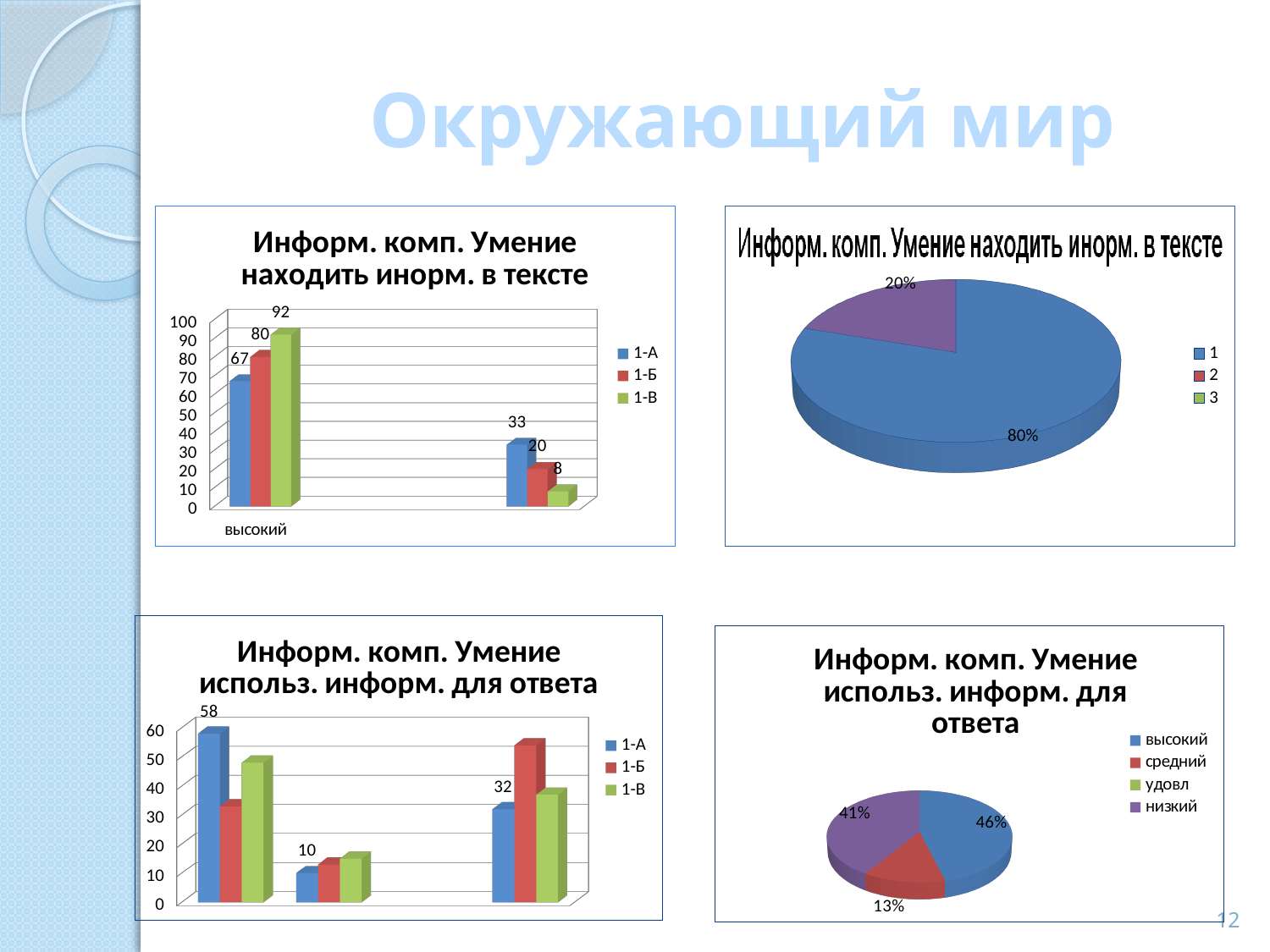
In the top-left bar chart 'Информ. комп. Умение находить инорм. в тексте', which series has the highest value in the 'высокий' category? 1-В In the bottom-left bar chart 'Информ. комп. Умение использ. информ. для ответа', what is the value for 1-А in the first category group? 58 In the bottom-right pie chart 'Информ. комп. Умение использ. информ. для ответа', what share does 'высокий' have? 46% In the top-left bar chart 'Информ. комп. Умение находить инорм. в тексте', how many series does the legend list? 3 In the bottom-left bar chart 'Информ. комп. Умение использ. информ. для ответа', is the value for 1-Б in the first category group greater or less than 40? less In the bottom-right pie chart 'Информ. комп. Умение использ. информ. для ответа', which is larger, 'высокий' or 'низкий'? высокий In the top-left bar chart 'Информ. комп. Умение находить инорм. в тексте', what is the value for 1-В in the 'высокий' category? 92 In the top-left bar chart 'Информ. комп. Умение находить инорм. в тексте', what is the value for 1-А in the 'высокий' category? 67 What kind of chart is the bottom-left chart 'Информ. комп. Умение использ. информ. для ответа'? bar chart In the top-right pie chart 'Информ. комп. Умение находить инорм. в тексте', what share does the largest slice have? 80% In the top-right pie chart 'Информ. комп. Умение находить инорм. в тексте', how many entries does the legend list? 3 In the top-left bar chart 'Информ. комп. Умение находить инорм. в тексте', what is the difference between the 1-В and 1-А values in the 'высокий' category? 25